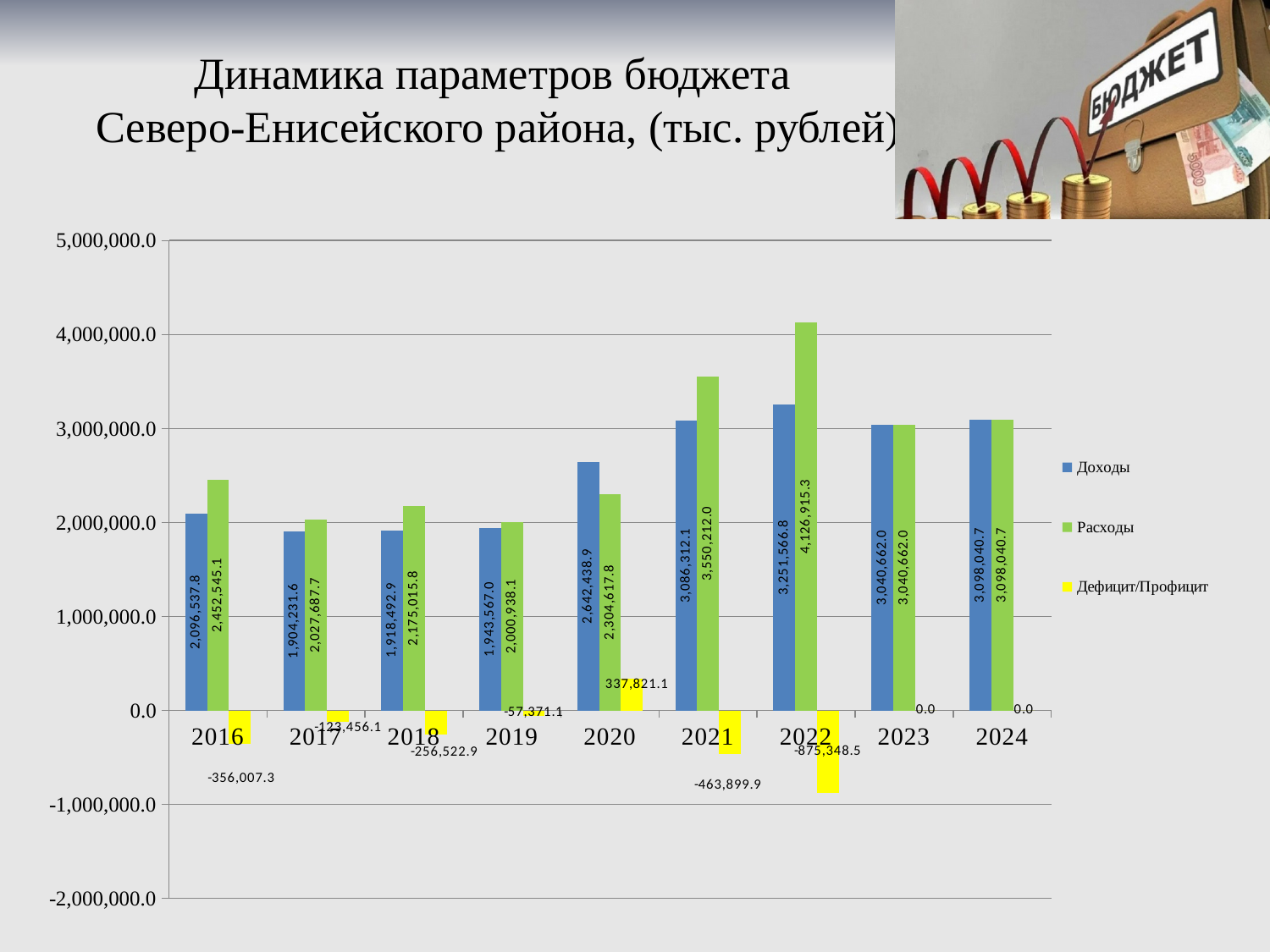
What colour represents the Дефицит/Профицит series? yellow In which year is Расходы the highest? 2022 In which year is Доходы the lowest? 2017 What is the value of Расходы for 2021? 3,550,212.0 Which is larger in 2020, Доходы or Расходы? Доходы What is the difference between Расходы and Доходы in 2016? 356,007.3 How many series does the legend list? 3 What is the value of Доходы for 2020? 2,642,438.9 What is the value of Дефицит/Профицит for 2022? -875,348.5 How many years are shown on the x axis? 9 Is the value of Расходы for 2022 greater or less than 4,000,000.0? greater What kind of chart is shown on the slide? bar chart